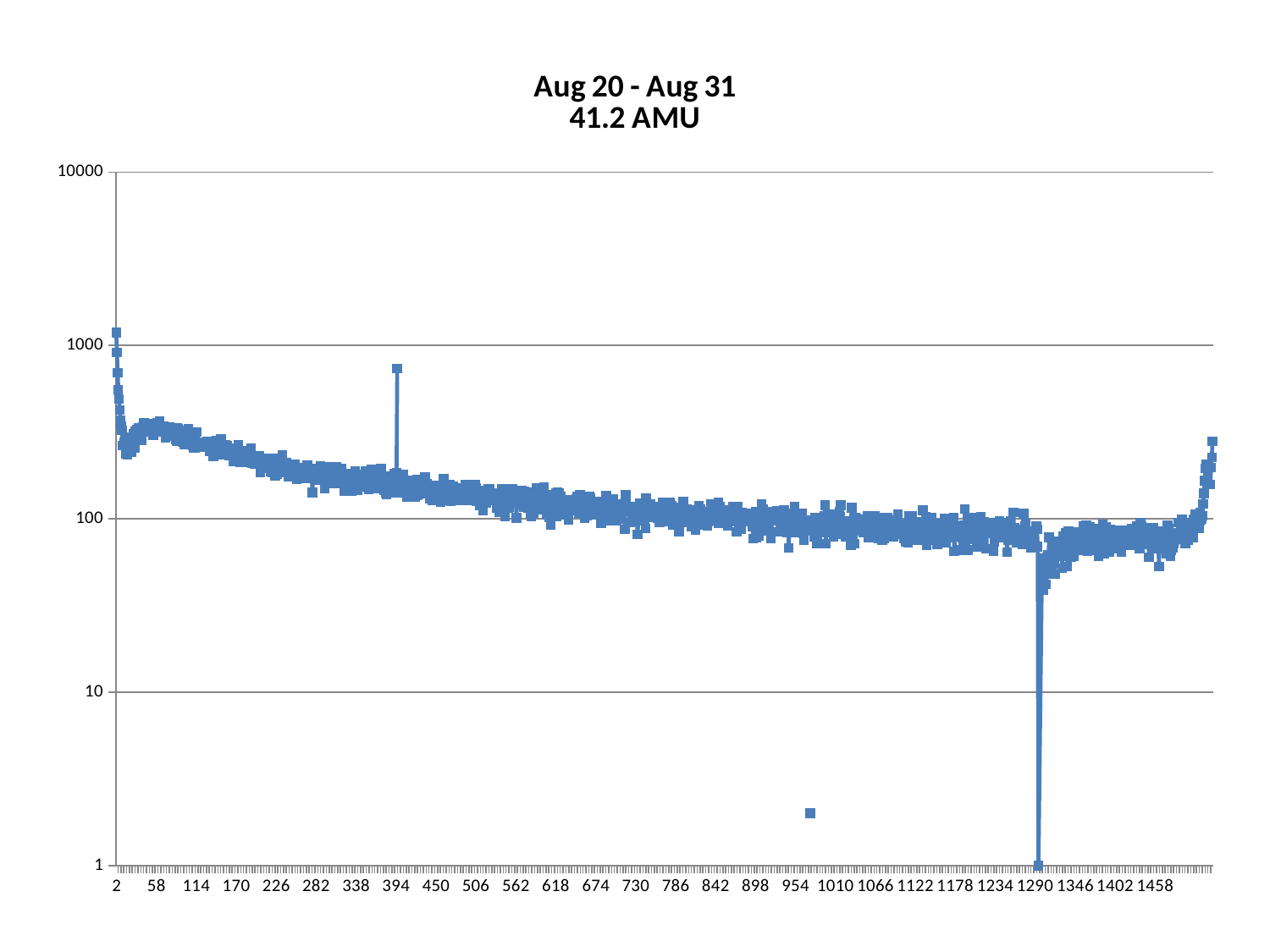
Are the values around x = 842 greater or less than 1000? less Is the value at the sharp dip near x = 1290 greater or less than 10? less Are the values around x = 842 greater or less than 10? greater What kind of chart is shown on the slide? Line chart with markers What is the highest value shown on the y axis? 10000 Do the values generally rise or fall along the x axis between 58 and 1290? Fall What is the title of the chart? Aug 20 - Aug 31 41.2 AMU